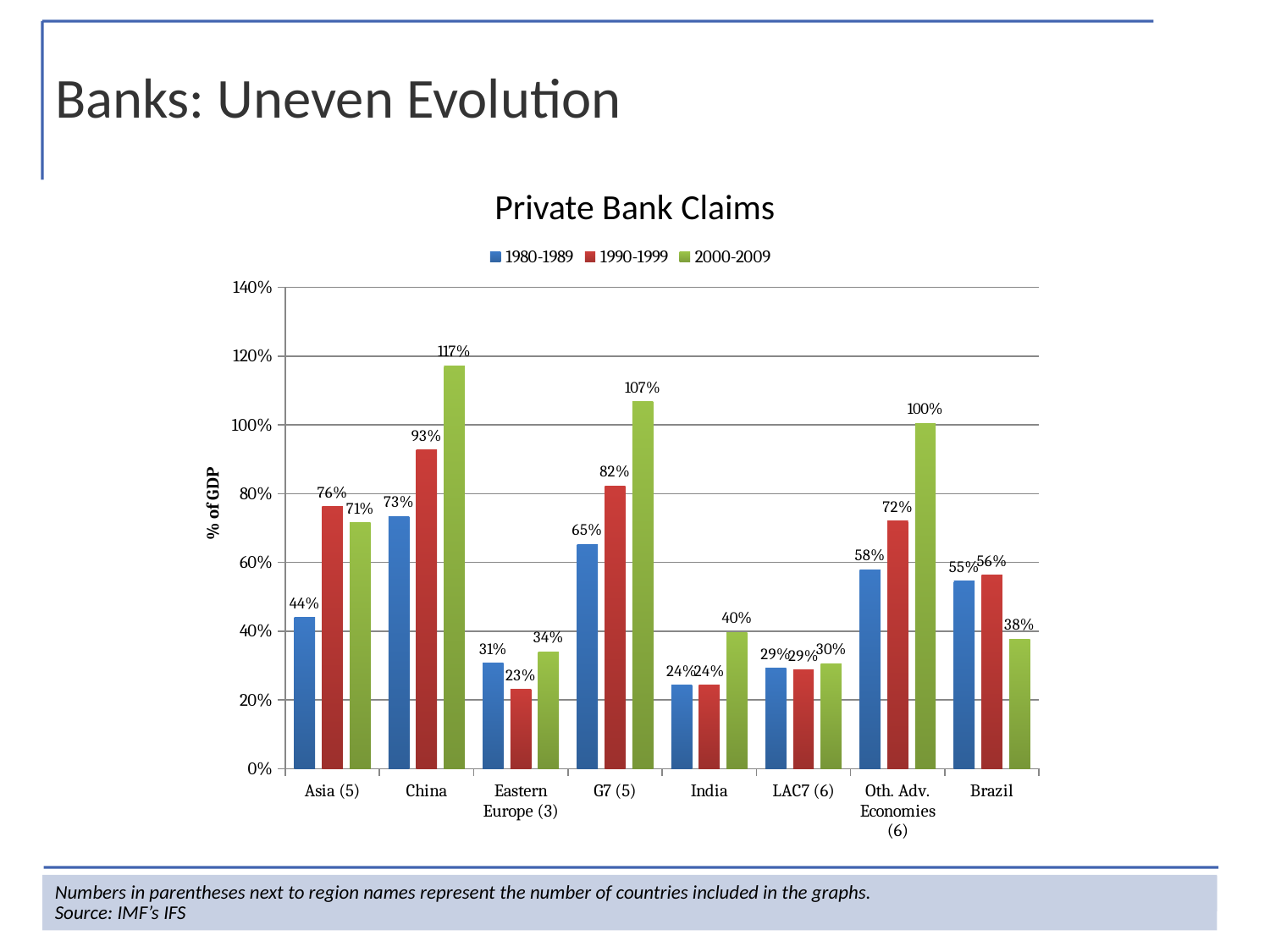
What kind of chart is this? bar chart How many series does the legend list? 3 Is the value for Asia (5) in the 1990-1999 series greater or less than 60%? greater What is the title of the chart? Private Bank Claims What is the value for China in the 2000-2009 series? 117% Which category has the lowest value in the 1980-1989 series? India How many categories are shown on the x axis? 8 What is the value for Eastern Europe (3) in the 1990-1999 series? 23% What is the difference between the 2000-2009 and 1980-1989 values for G7 (5)? 42% Which is larger for Brazil: the 1990-1999 value or the 2000-2009 value? 1990-1999 What is the value for Oth. Adv. Economies (6) in the 2000-2009 series? 100% Which category has the highest value in the 2000-2009 series? China